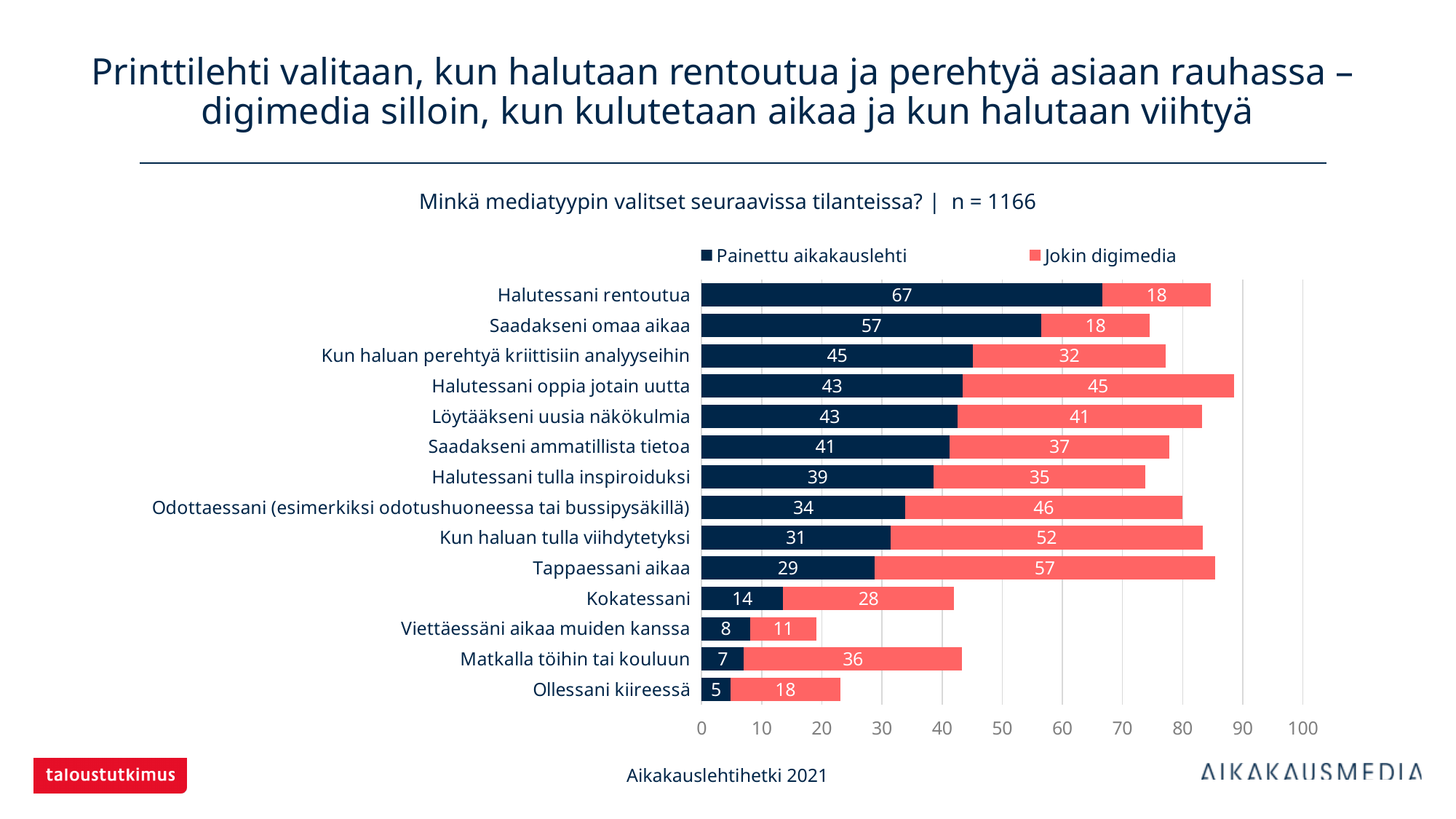
How many categories are shown in the chart? 14 What kind of chart is shown on the slide? Stacked bar chart How many series does the legend list? 2 What is the value for Painettu aikakauslehti in the Halutessani rentoutua category? 67 What is the difference between the Painettu aikakauslehti and Jokin digimedia values in the Kun haluan tulla viihdytetyksi category? 21 What is the total of the stacked bar for Halutessani oppia jotain uutta? 88 In the Kokatessani category, which is larger: Painettu aikakauslehti or Jokin digimedia? Jokin digimedia Which category has the highest value for Painettu aikakauslehti? Halutessani rentoutua Which category has the lowest value for Painettu aikakauslehti? Ollessani kiireessä What is the value for Jokin digimedia in the Matkalla töihin tai kouluun category? 36 What is the value for Jokin digimedia in the Tappaessani aikaa category? 57 Which category has the highest value for Jokin digimedia? Tappaessani aikaa